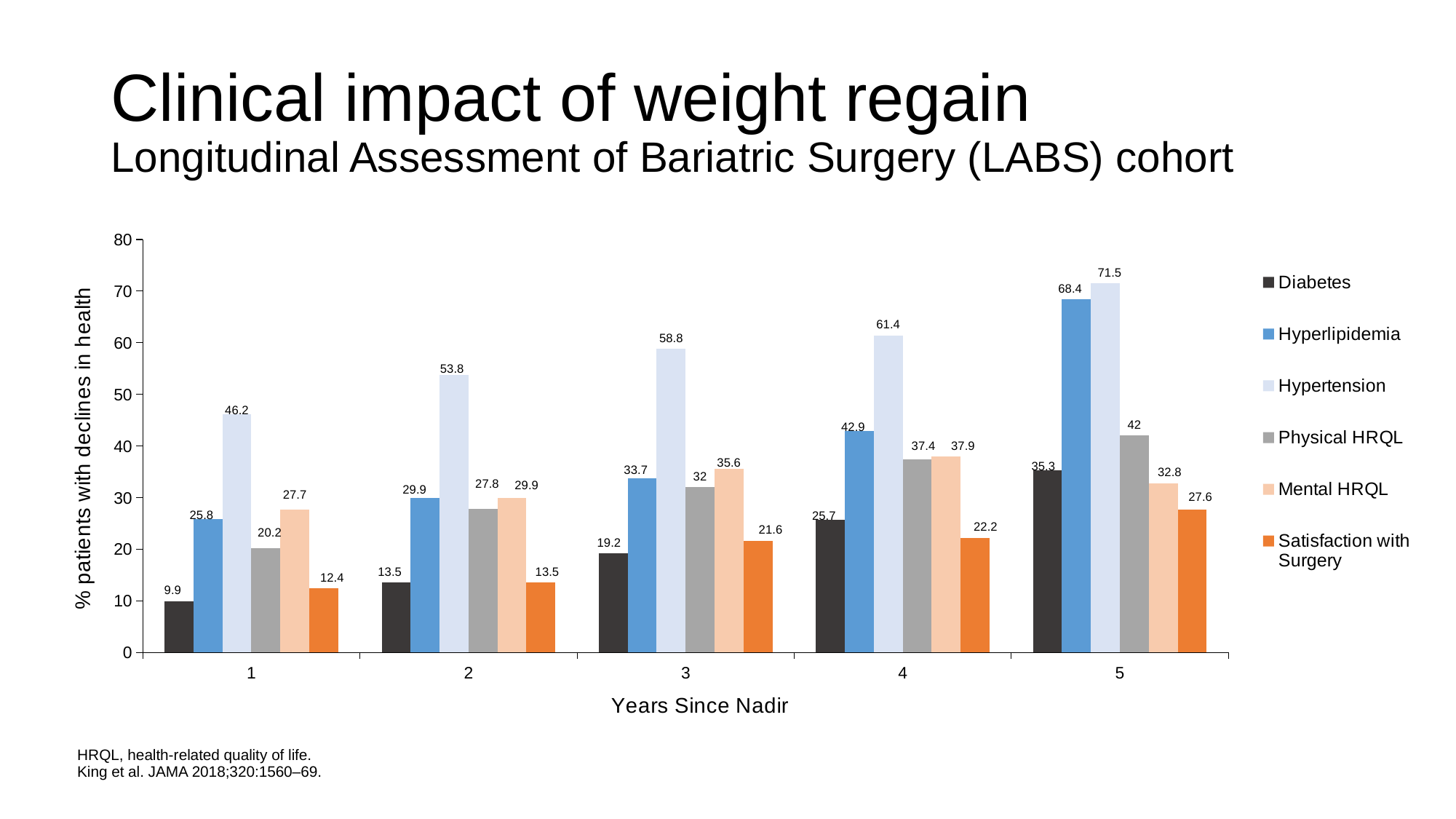
What kind of chart is shown on the slide? Bar chart What is the value for Satisfaction with Surgery at 5 years since nadir? 27.6 How many categories are shown on the x axis? 5 What is the value for Diabetes at 1 year since nadir? 9.9 Which is larger at 4 years since nadir: Physical HRQL or Mental HRQL? Mental HRQL Is the value for Hypertension at 5 years since nadir greater or less than 70? greater How many series does the legend list? 6 What is the difference between the Hyperlipidemia values at 5 years and 1 year since nadir? 42.6 Which series has the highest value at 5 years since nadir? Hypertension Do the Diabetes values rise or fall as years since nadir increase? Rise What is the value for Hypertension at 3 years since nadir? 58.8